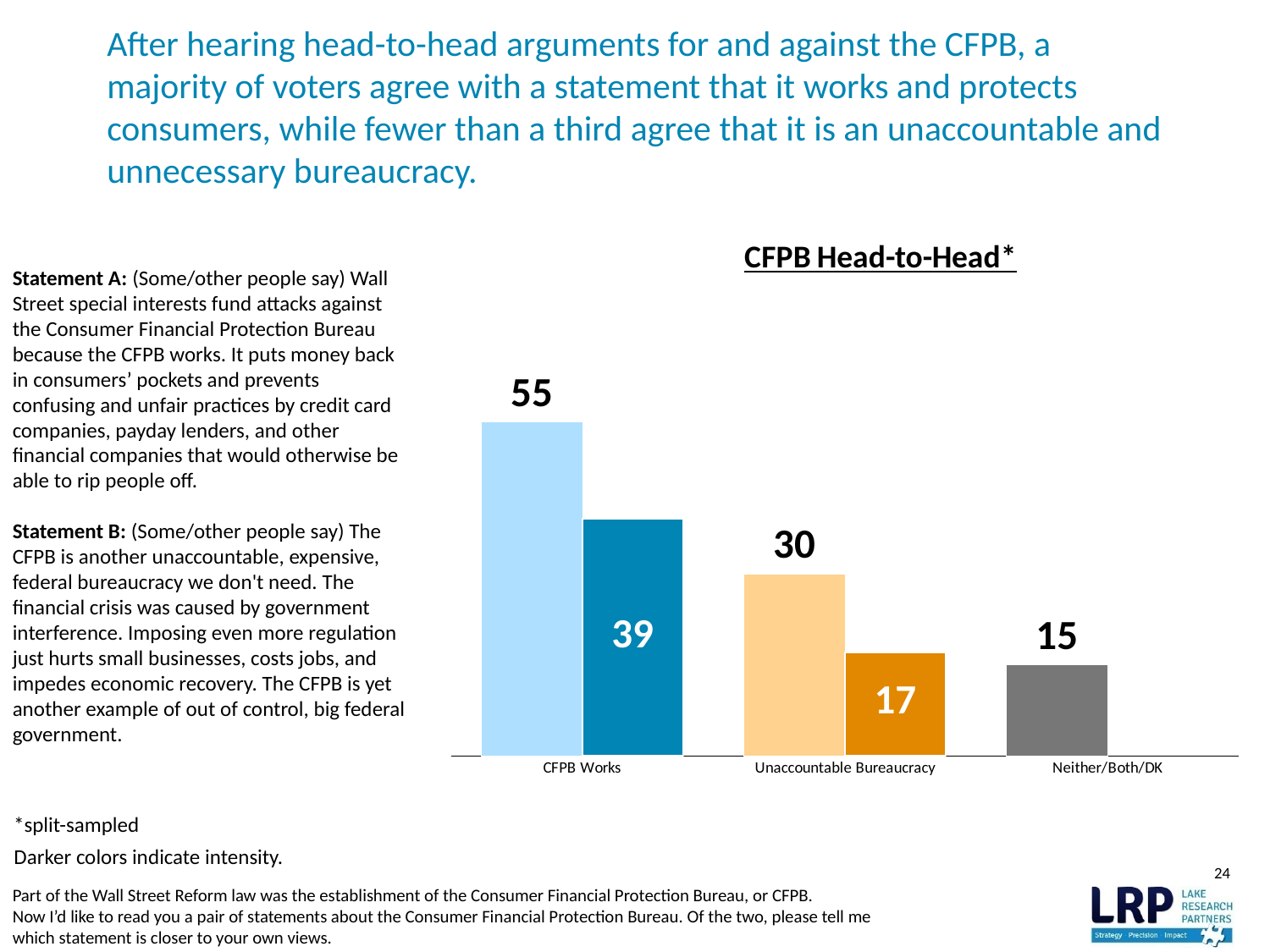
How many categories are shown on the x axis of the chart? 3 What value is printed on the darker bar for Unaccountable Bureaucracy? 17 Which category has the highest total value? CFPB Works What is the title of the chart? CFPB Head-to-Head* Which category has the lowest value? Neither/Both/DK What is the total value shown for Unaccountable Bureaucracy? 30 What is the total value shown for CFPB Works? 55 What value is printed on the darker bar for CFPB Works? 39 What is the difference between the total for CFPB Works and the total for Unaccountable Bureaucracy? 25 What is the value shown for Neither/Both/DK? 15 Which is larger, the darker bar for CFPB Works or the darker bar for Unaccountable Bureaucracy? CFPB Works What type of chart is shown on the slide? bar chart